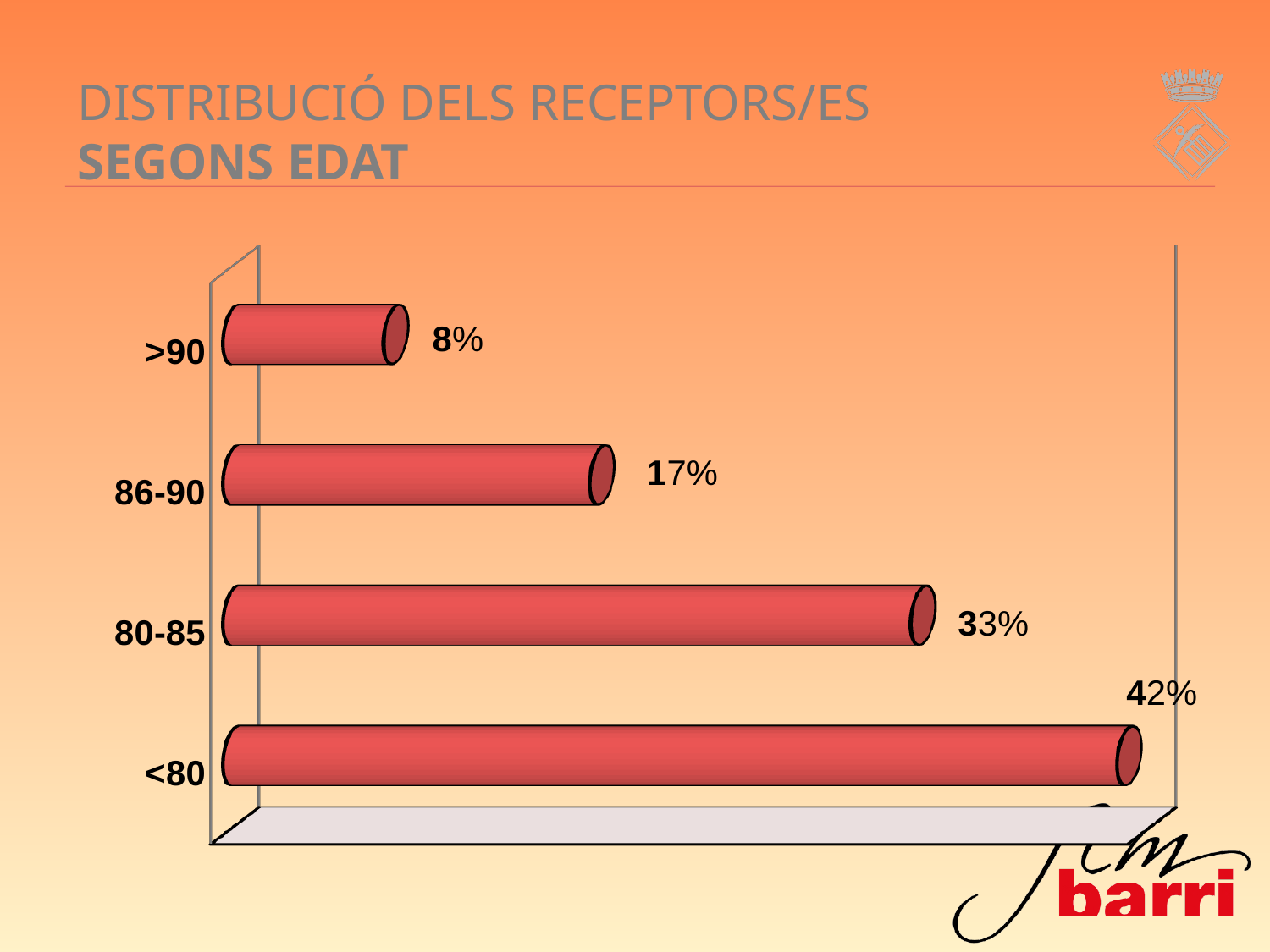
Which is larger, the value for 80-85 or the value for 86-90? 80-85 What is the value for the 86-90 age group? 17% What is the value for the >90 age group? 8% What is the difference between the values for <80 and 80-85? 9% How many age groups are shown in the chart? 4 Which age group has the lowest value? >90 What is the value for the 80-85 age group? 33% Which age group has the highest value? <80 What is the value for the <80 age group? 42% What kind of chart is shown on the slide? Bar chart What is the title of the slide containing the chart? DISTRIBUCIÓ DELS RECEPTORS/ES SEGONS EDAT What is the difference between the values for 86-90 and >90? 9%